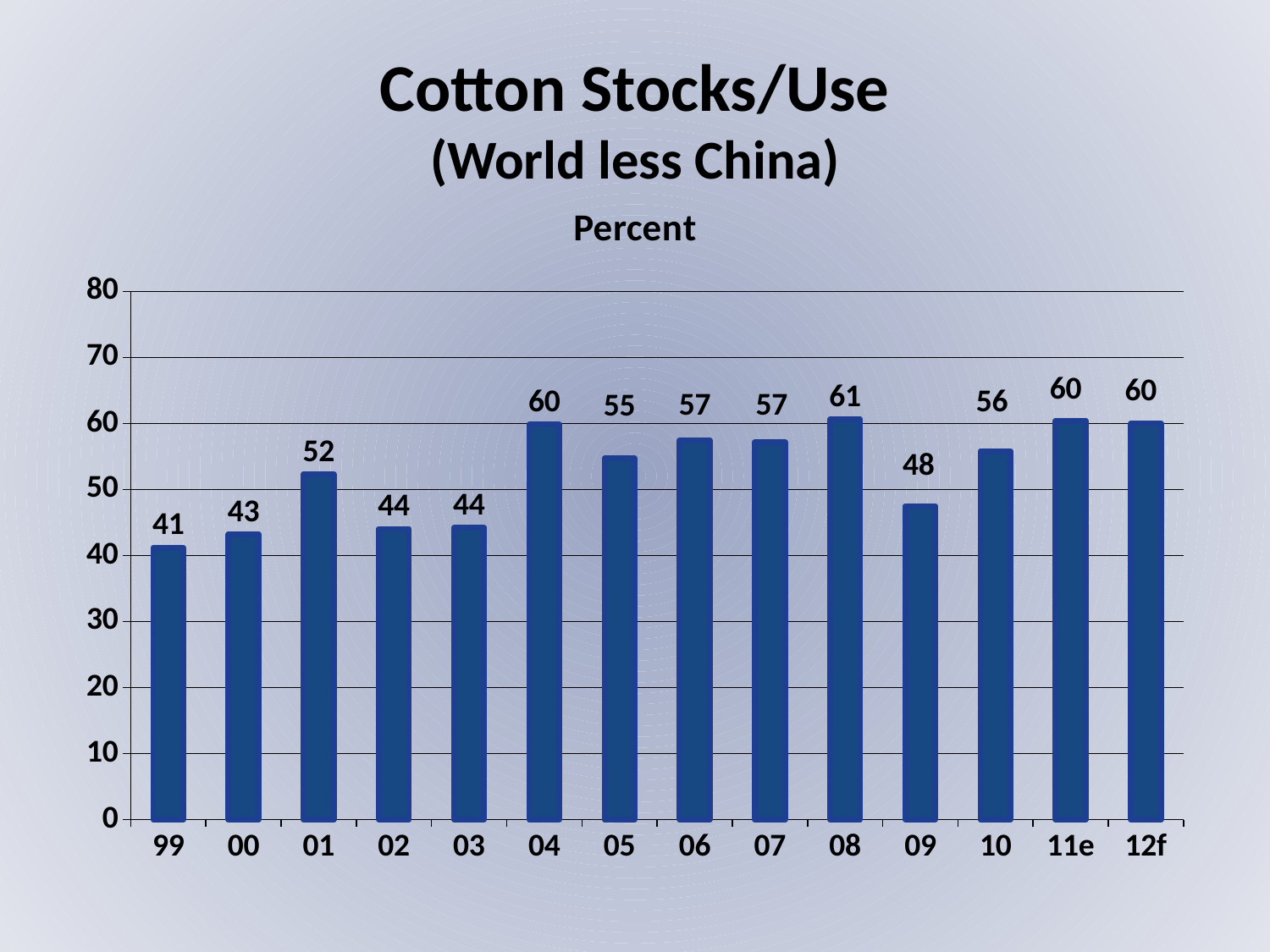
How many bars are shown in the chart? 14 What is the value shown for 12f? 60 Which is larger, the value for 04 or the value for 05? 04 What kind of chart is shown on the slide? Bar chart What is the difference between the values for 08 and 09? 13 Which year has the highest stocks/use value? 08 Which year has the lowest stocks/use value? 99 What unit is indicated above the chart? Percent What is the value shown for 09? 48 What is the value shown for 08? 61 What is the cotton stocks/use value for 99? 41 What is the difference between the values for 01 and 00? 9